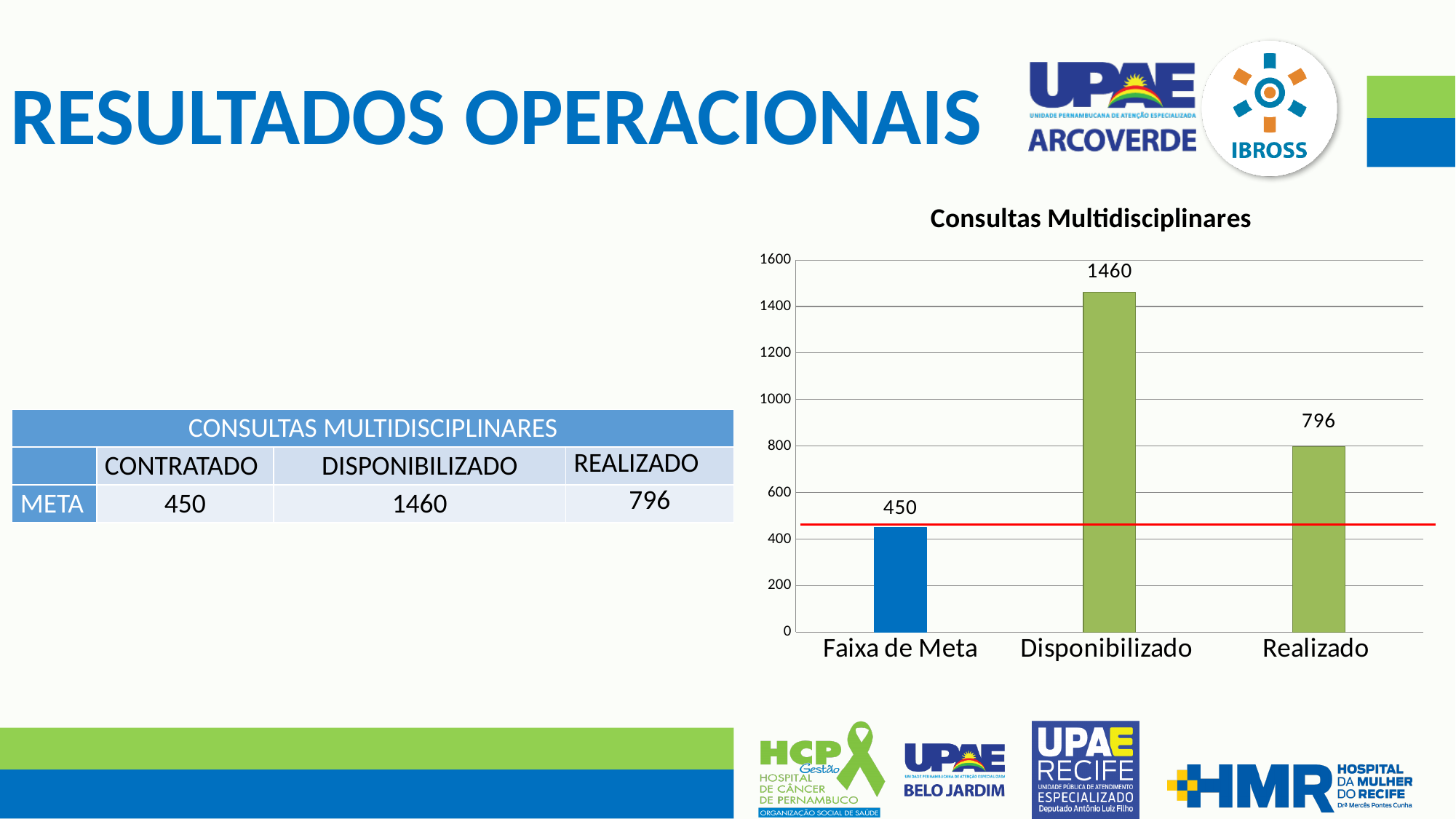
How many categories are shown on the x axis of the Consultas Multidisciplinares chart? 3 What is the difference between Disponibilizado and Realizado in the Consultas Multidisciplinares chart? 664 What is the title of the chart on the slide? Consultas Multidisciplinares Is the value for Realizado greater or less than 1000 in the Consultas Multidisciplinares chart? less What is the difference between Realizado and Faixa de Meta in the Consultas Multidisciplinares chart? 346 Which category has the highest value in the Consultas Multidisciplinares chart? Disponibilizado What is the value for Faixa de Meta in the Consultas Multidisciplinares chart? 450 Which category has the lowest value in the Consultas Multidisciplinares chart? Faixa de Meta What is the value for Realizado in the Consultas Multidisciplinares chart? 796 Which is larger in the Consultas Multidisciplinares chart, Realizado or Faixa de Meta? Realizado What is the value for Disponibilizado in the Consultas Multidisciplinares chart? 1460 What kind of chart is the Consultas Multidisciplinares chart? bar chart